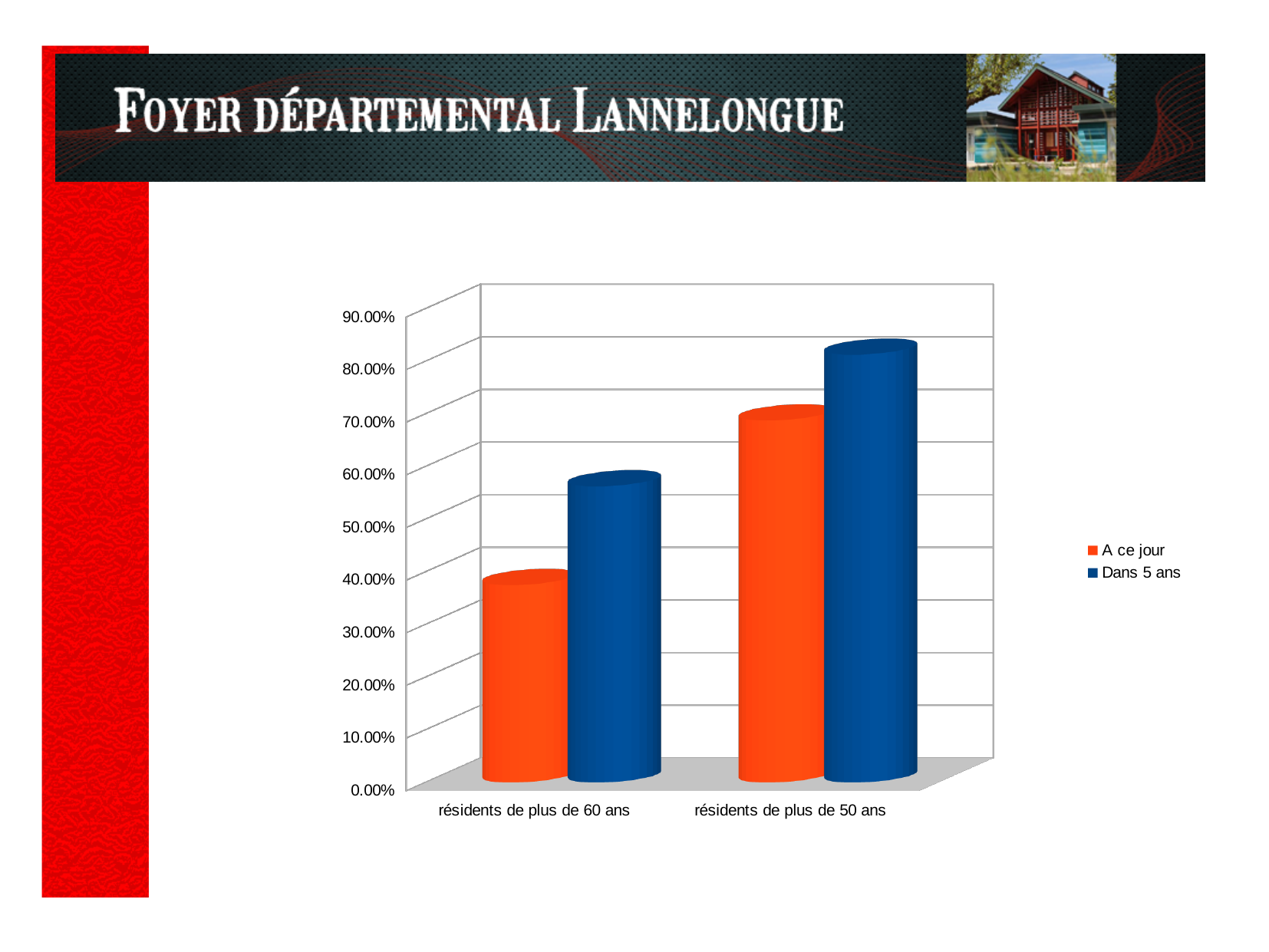
How many series does the chart's legend list? 2 Is the Dans 5 ans value for résidents de plus de 50 ans greater or less than 70.00%? greater Which series is shown in orange in the chart's legend? A ce jour What kind of chart is shown on the slide? bar chart For résidents de plus de 60 ans, which is larger: A ce jour or Dans 5 ans? Dans 5 ans For résidents de plus de 50 ans, which is larger: A ce jour or Dans 5 ans? Dans 5 ans Which bar is the lowest in the chart? A ce jour for résidents de plus de 60 ans Is the A ce jour value for résidents de plus de 60 ans greater or less than 50.00%? less Which bar is the highest in the chart? Dans 5 ans for résidents de plus de 50 ans How many categories are shown on the x axis of the chart? 2 Which series is shown in blue in the chart's legend? Dans 5 ans Do the A ce jour values rise or fall from résidents de plus de 60 ans to résidents de plus de 50 ans? rise